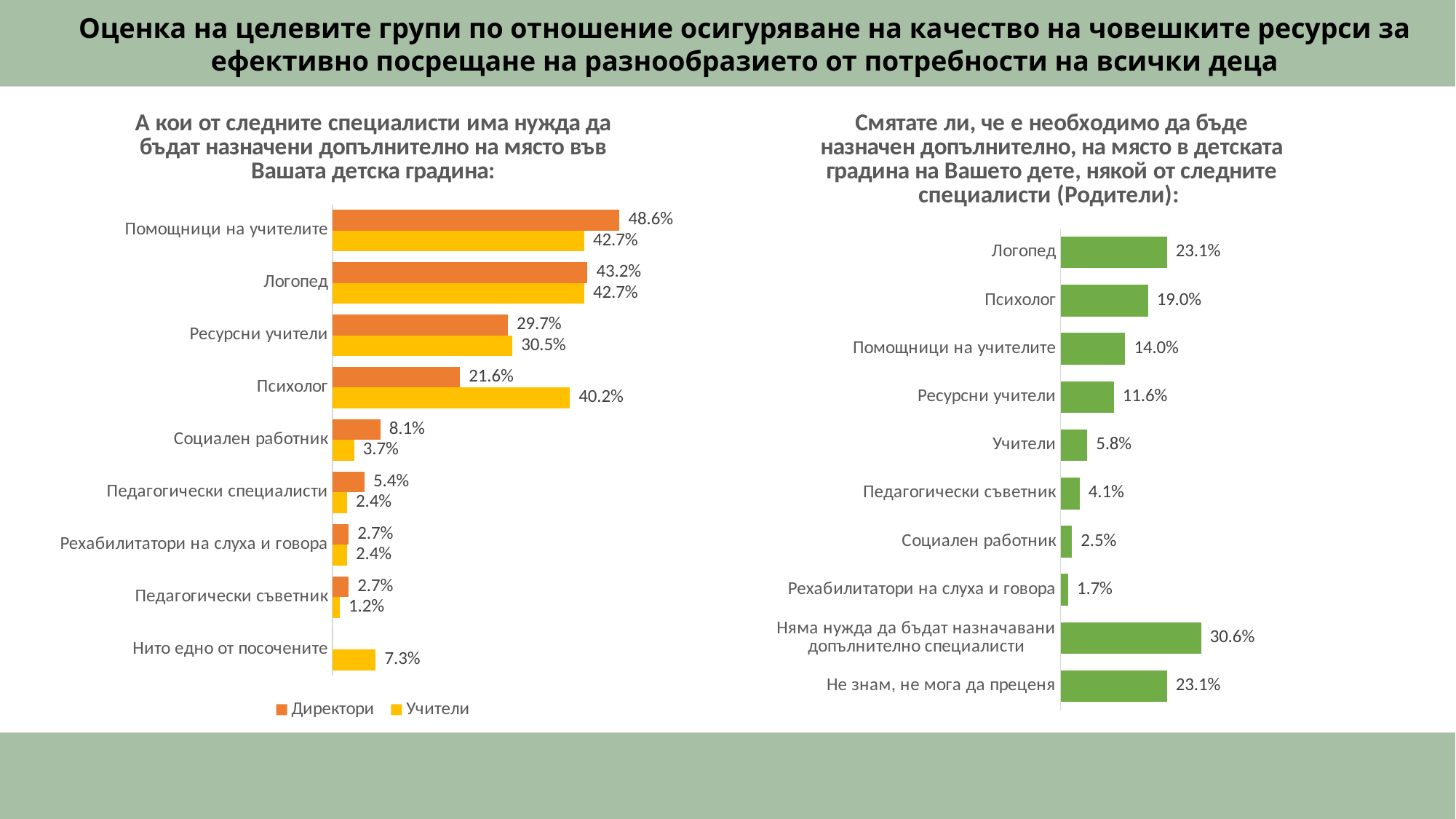
In the left chart, which category has the highest value for Директори? Помощници на учителите In the left chart, what is the value for Учители for Психолог? 40.2% In the left chart, which category has the lowest value for Учители? Педагогически съветник In the left chart, what is the value for Директори for Помощници на учителите? 48.6% In the left chart, which is larger for Ресурсни учители: the Директори value or the Учители value? Учители In the left chart, what is the difference between the Учители and Директори values for Психолог? 18.6% How many categories are shown in the left chart? 9 How many series does the legend of the left chart list? 2 In the right chart (Родители), what is the value for Логопед? 23.1% What type of chart is the right chart (Родители)? Bar chart In the right chart (Родители), which category has the lowest value? Рехабилитатори на слуха и говора In the right chart (Родители), which category has the highest value? Няма нужда да бъдат назначавани допълнително специалисти